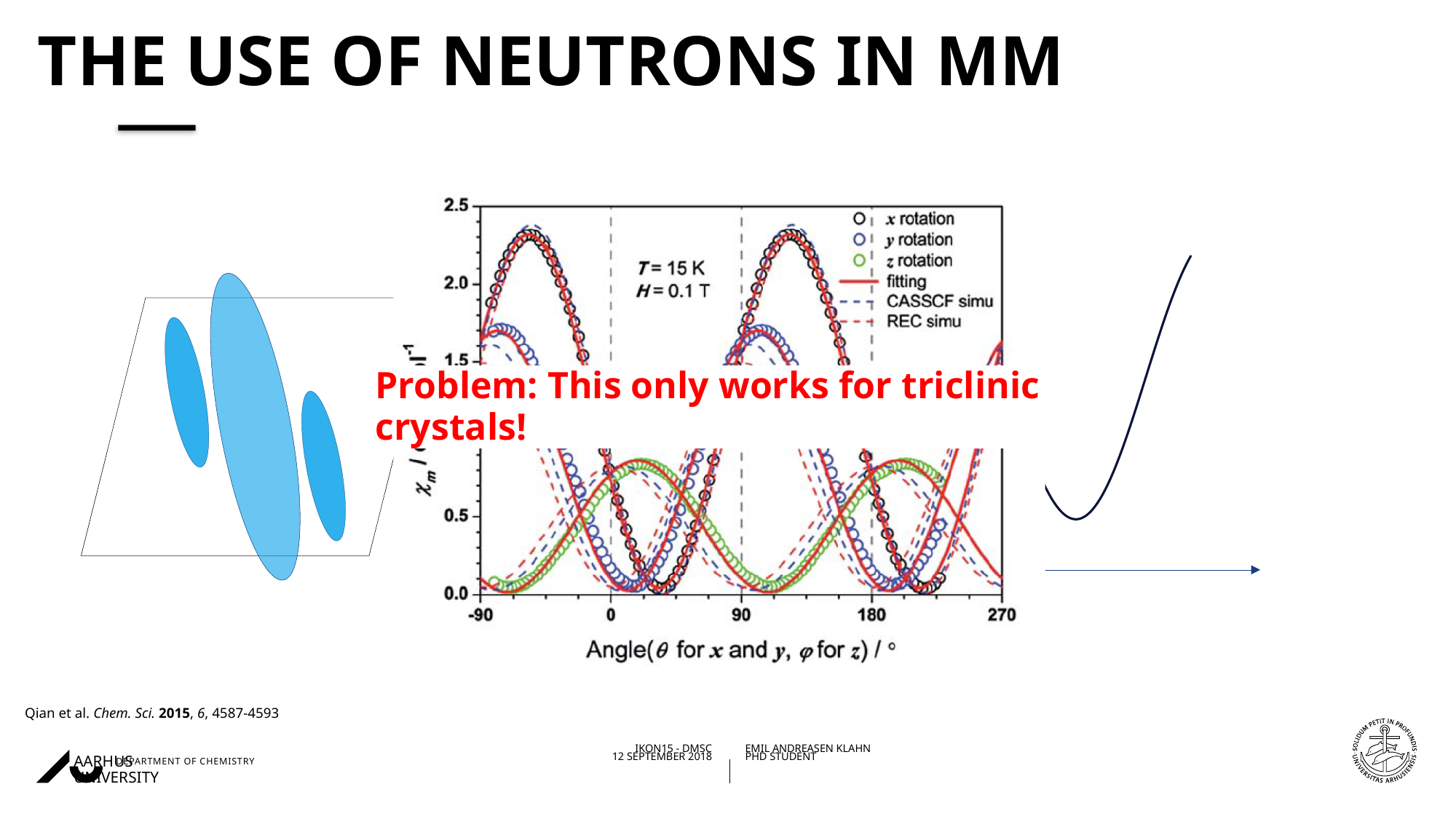
Is the peak value of the x rotation series near -30° greater or less than 2.0? greater Which series reaches a higher peak value, x rotation or z rotation? x rotation What is the lowest tick value shown on the x axis of the chart? -90 What is the label of the x axis of the chart? Angle(θ for x and y, φ for z) / ° How many labelled tick values are shown on the x axis of the chart? 5 What is the highest tick value shown on the y axis of the chart? 2.5 How many entries does the chart's legend list? 6 Is the peak value of the z rotation series greater or less than 0.5? greater What temperature is stated on the chart? T = 15 K Is the peak value of the y rotation series near -60° greater or less than 2.0? less What is the highest tick value shown on the x axis of the chart? 270 What kind of chart is shown on the slide? line chart with scatter points